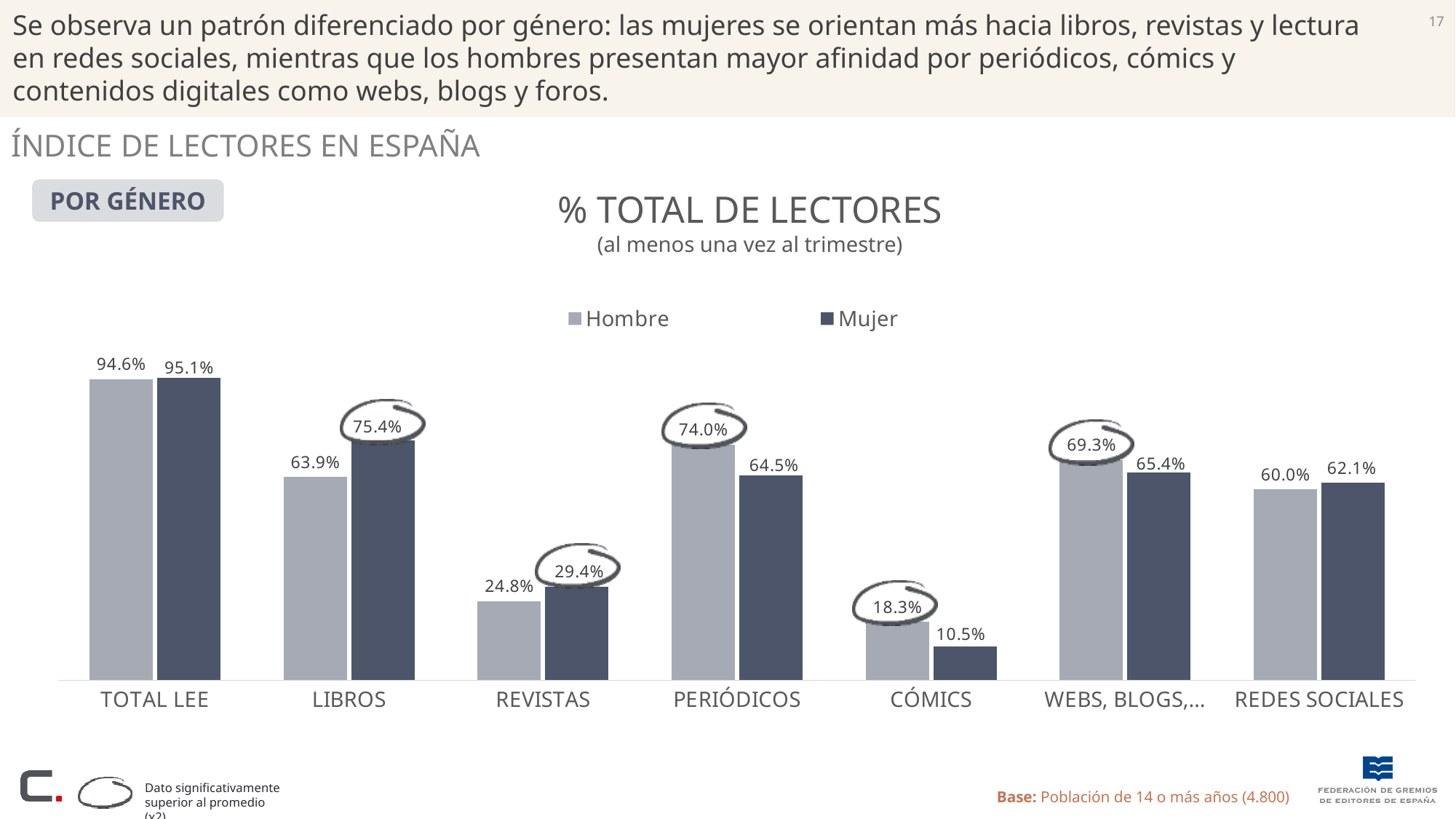
What is the difference between the Mujer and Hombre values for LIBROS? 11.5% What is the difference between the Hombre and Mujer values for CÓMICS? 7.8% What kind of chart is shown on the slide? Bar chart What is the value for Mujer in the CÓMICS category? 10.5% How many series does the legend list? 2 What is the value for Hombre in the PERIÓDICOS category? 74.0% How many categories are shown on the x axis? 7 Which category has the lowest value for Hombre? CÓMICS Which category has the highest value for Mujer? TOTAL LEE What is the value for Mujer in the LIBROS category? 75.4% Which is larger for WEBS, BLOGS,..., the Hombre value or the Mujer value? Hombre Which is larger for REVISTAS, the Hombre value or the Mujer value? Mujer